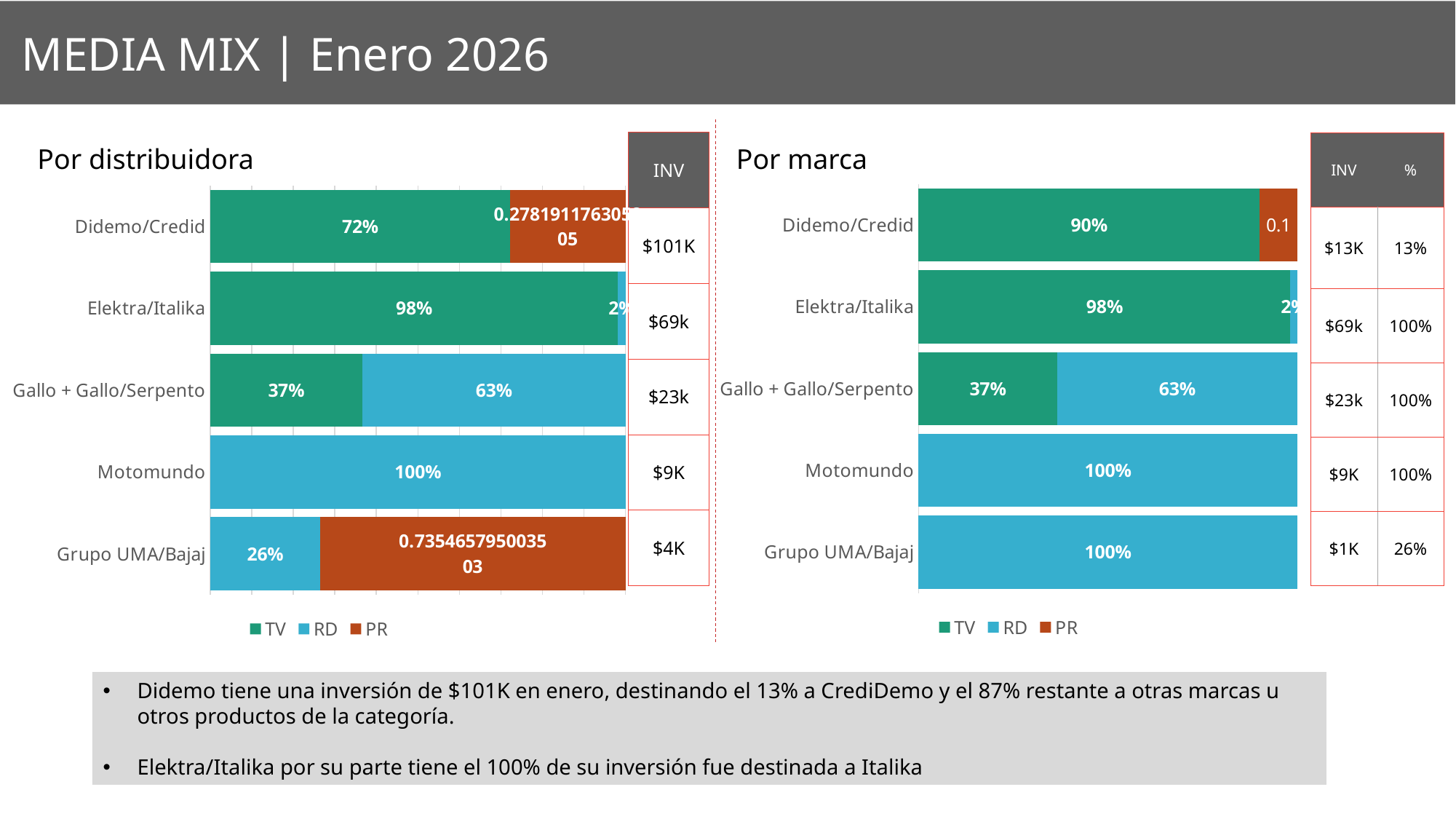
What kind of chart is the 'Por marca' chart? Stacked bar chart How many categories are shown in the 'Por marca' chart? 5 In the 'Por distribuidora' chart, for Gallo + Gallo/Serpento, which is larger: the TV share or the RD share? RD How many series does the legend of the 'Por distribuidora' chart list? 3 In the 'Por distribuidora' chart, which category has the highest TV share? Elektra/Italika In the 'Por marca' chart, what is the RD share for Grupo UMA/Bajaj? 100% In the 'Por distribuidora' chart, what is the RD share for Gallo + Gallo/Serpento? 63% In the 'Por marca' chart, what is the RD share for Elektra/Italika? 2% What are the legend entries of the 'Por marca' chart? TV, RD, PR In the 'Por distribuidora' chart, what is the TV share for Didemo/Credid? 72% In the 'Por distribuidora' chart, what is the RD share for Grupo UMA/Bajaj? 26% In the 'Por marca' chart, what is the TV share for Didemo/Credid? 90%